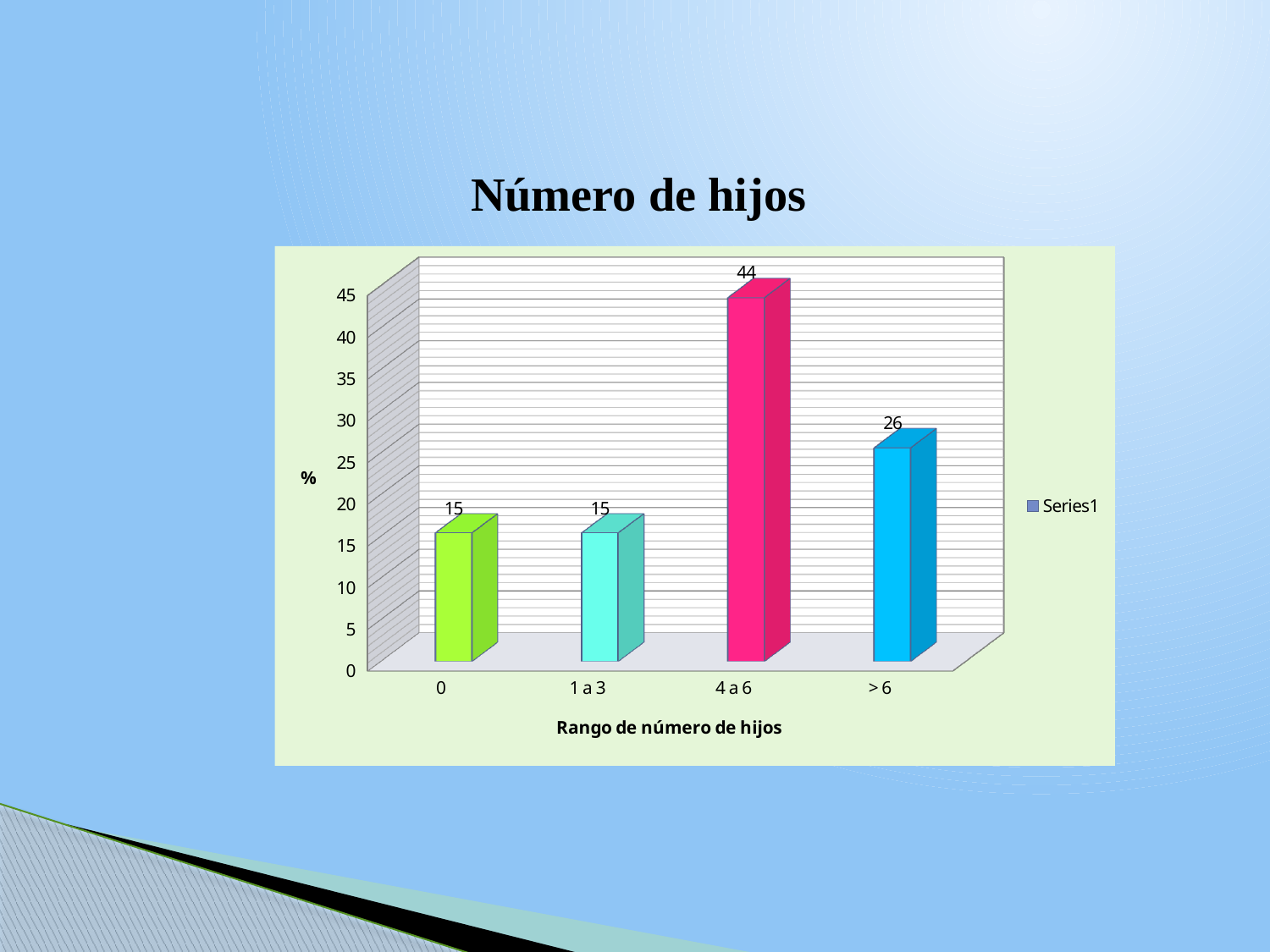
What kind of chart is shown on the slide? bar chart Which is larger, the value for "> 6" or the value for "1 a 3"? > 6 What is the difference between the values for "4 a 6" and "> 6"? 18 Is the value for "4 a 6" greater or less than 40? greater What is the difference between the values for "> 6" and "1 a 3"? 11 What is the title of the chart? Número de hijos How many series does the legend list? 1 Which category has the highest value? 4 a 6 What is the value for the "4 a 6" category? 44 What is the value for the "0" category? 15 What is the value for the "> 6" category? 26 How many categories are shown on the x axis? 4